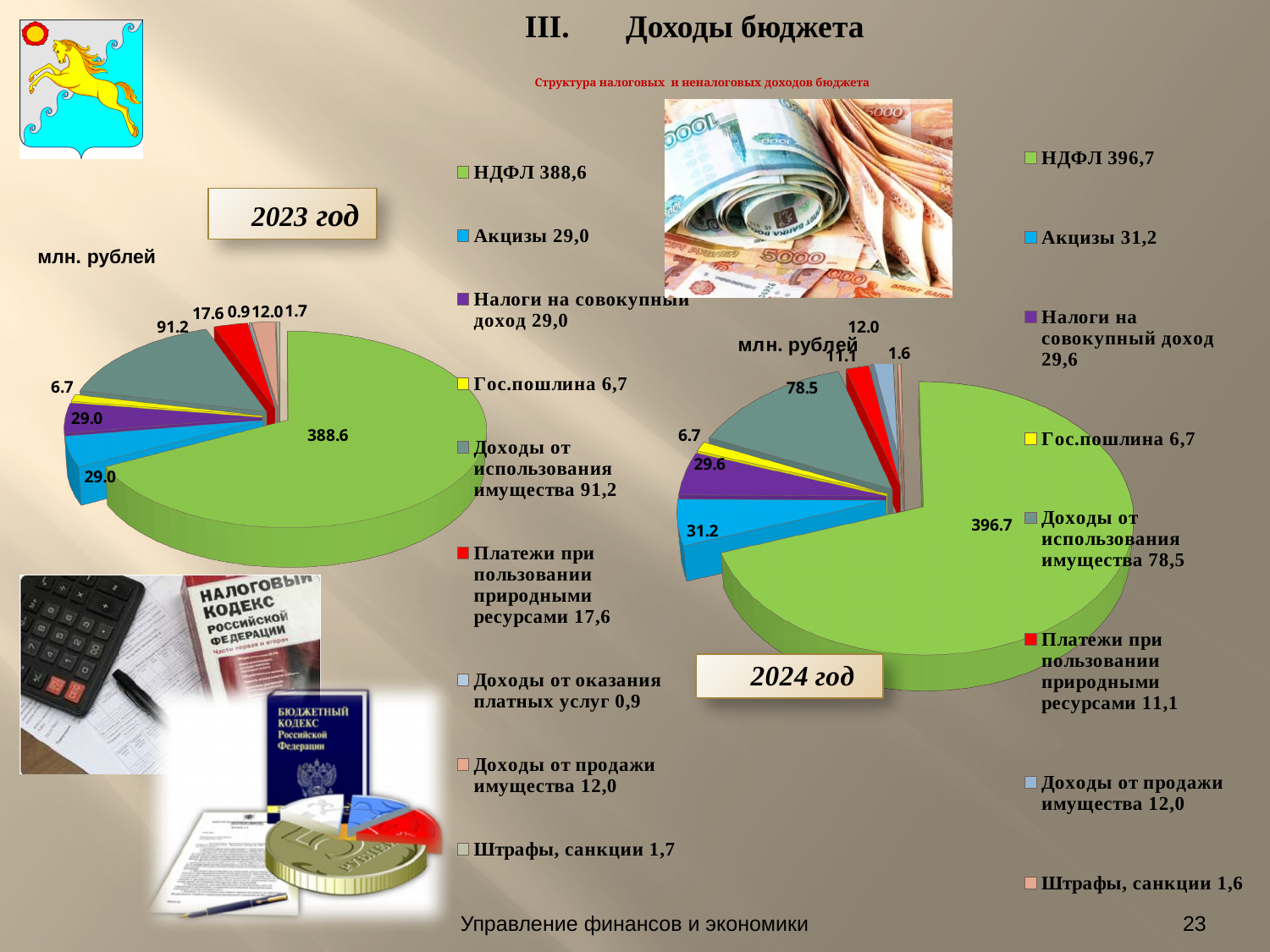
On the 2023 pie chart, what is the difference between Доходы от использования имущества and Платежи при пользовании природными ресурсами? 73.6 On the 2024 pie chart, what is the value for Акцизы? 31.2 How many categories does the 2024 pie chart show? 8 On the 2023 pie chart, what is the value for НДФЛ? 388.6 Which is larger: Доходы от использования имущества in the 2023 chart or in the 2024 chart? 2023 What is the difference between НДФЛ in the 2024 chart and НДФЛ in the 2023 chart? 8.1 What type of chart is used for the 2024 data? Pie chart On the 2023 pie chart, which category has the largest value? НДФЛ On the 2024 pie chart, what is the value for Доходы от использования имущества? 78.5 On the 2024 pie chart, which category has the smallest value? Штрафы, санкции How many categories does the 2023 pie chart show? 9 On the 2023 pie chart, which category has the smallest value? Доходы от оказания платных услуг